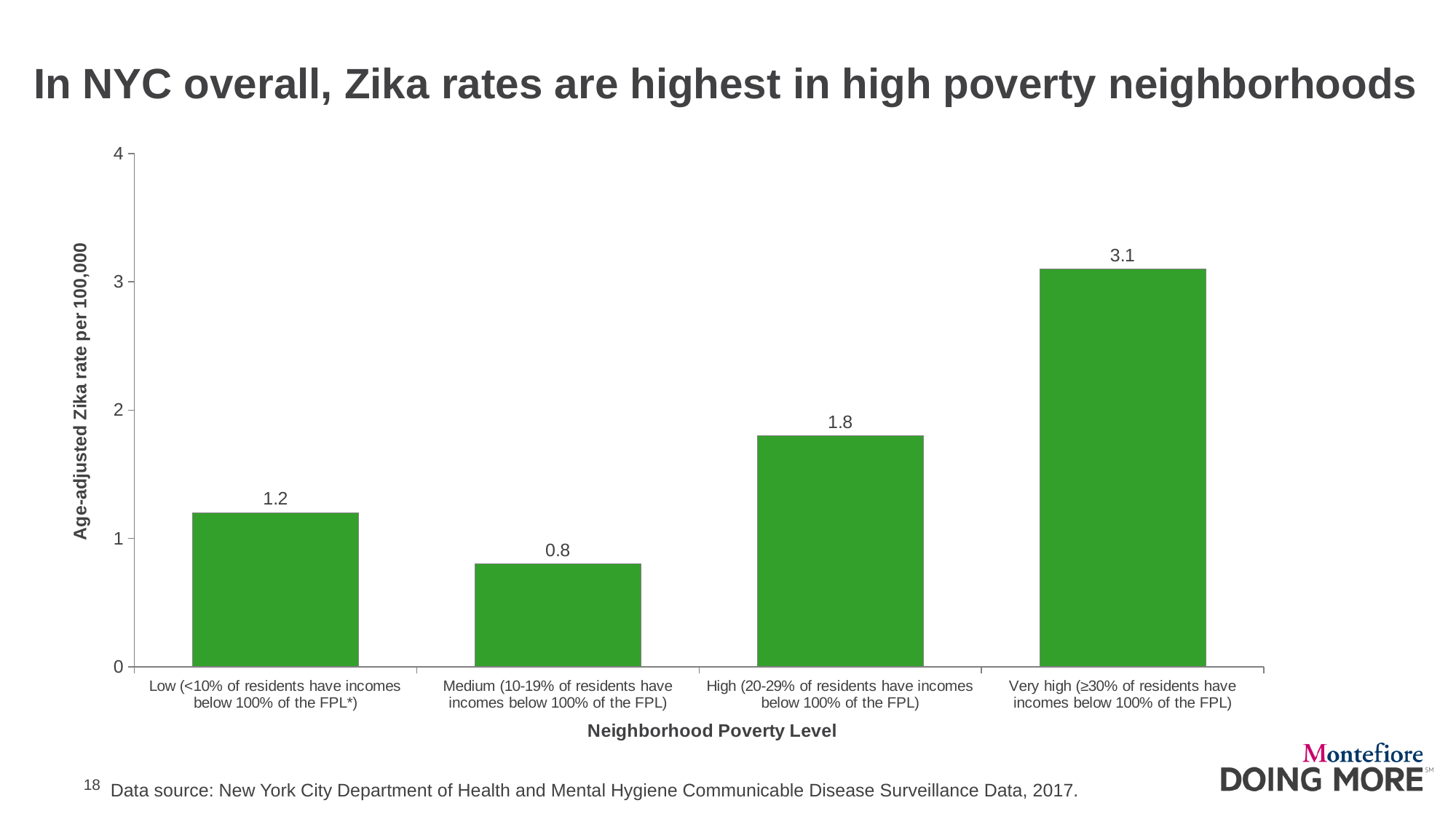
What kind of chart is shown on the slide? Bar chart Which neighborhood poverty level has the highest age-adjusted Zika rate? Very high Is the age-adjusted Zika rate for the Very high poverty neighborhoods greater or less than 3? greater What is the difference in age-adjusted Zika rate between the Very high and Low poverty neighborhoods? 1.9 What is the age-adjusted Zika rate per 100,000 for the Medium poverty neighborhoods? 0.8 What is the age-adjusted Zika rate per 100,000 for the Very high poverty neighborhoods? 3.1 What is the age-adjusted Zika rate per 100,000 for the High poverty neighborhoods? 1.8 Which has a higher age-adjusted Zika rate, the Low or the High poverty neighborhoods? High How many neighborhood poverty level categories are shown in the chart? 4 What is the label of the x axis of the chart? Neighborhood Poverty Level Which neighborhood poverty level has the lowest age-adjusted Zika rate? Medium What is the age-adjusted Zika rate per 100,000 for the Low poverty neighborhoods? 1.2